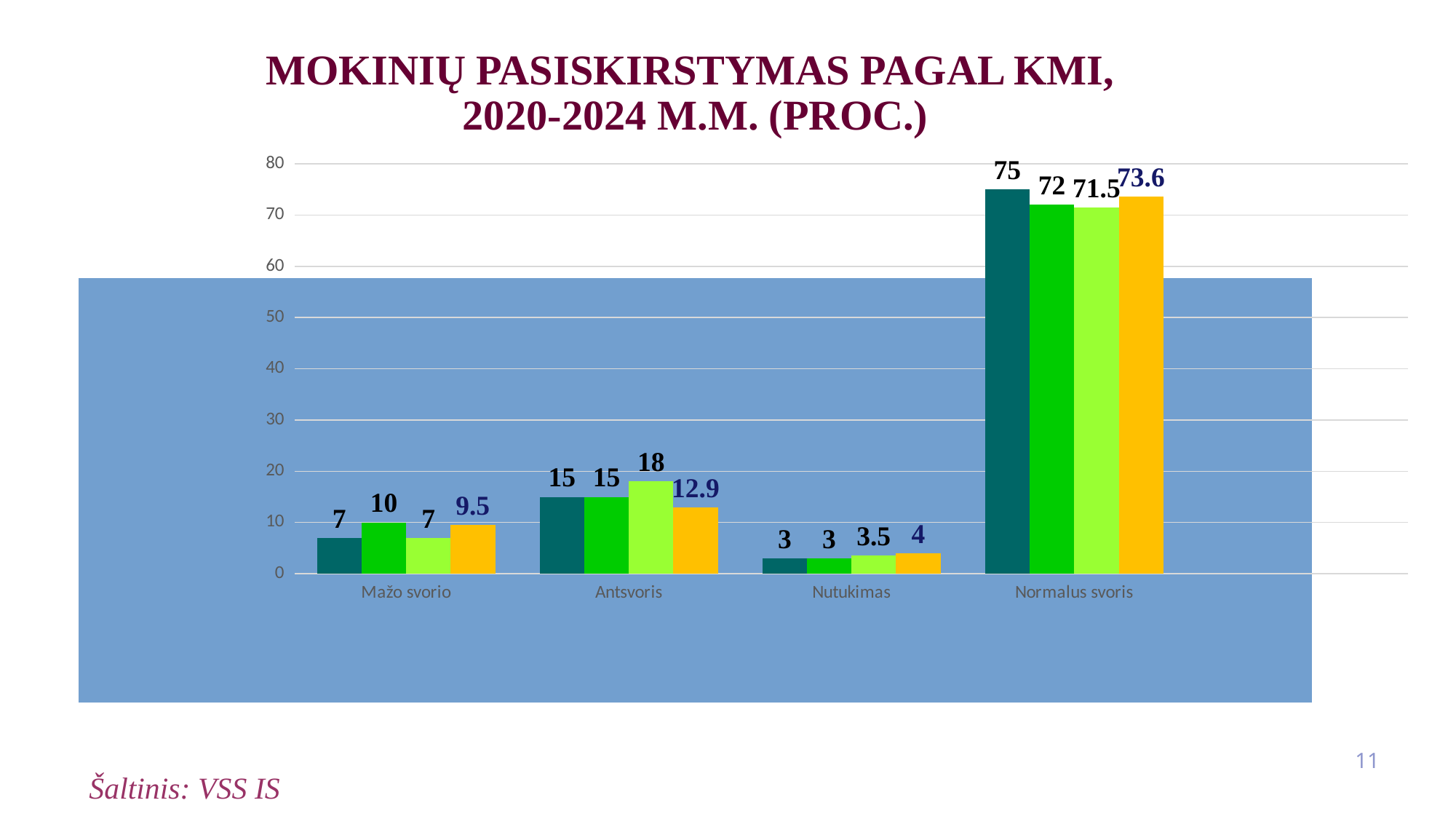
What is the value of the bright green (second) bar for Mažo svorio? 10 For Antsvoris, which is larger: the light green bar or the orange bar? the light green bar How many categories are shown on the x axis of the chart? 4 What is the value of the orange bar for Antsvoris? 12.9 Which category has the lowest values in the chart? Nutukimas What is the value of the first (dark teal) bar for Normalus svoris? 75 What type of chart is shown on the slide? bar chart Which category has the highest values in the chart? Normalus svoris What is the title of the chart? MOKINIŲ PASISKIRSTYMAS PAGAL KMI, 2020-2024 M.M. (PROC.) What is the value of the light green bar for Nutukimas? 3.5 What is the difference between the first (dark teal) bar and the orange bar for Normalus svoris? 1.4 Is the value of the orange bar for Normalus svoris greater or less than 70? greater